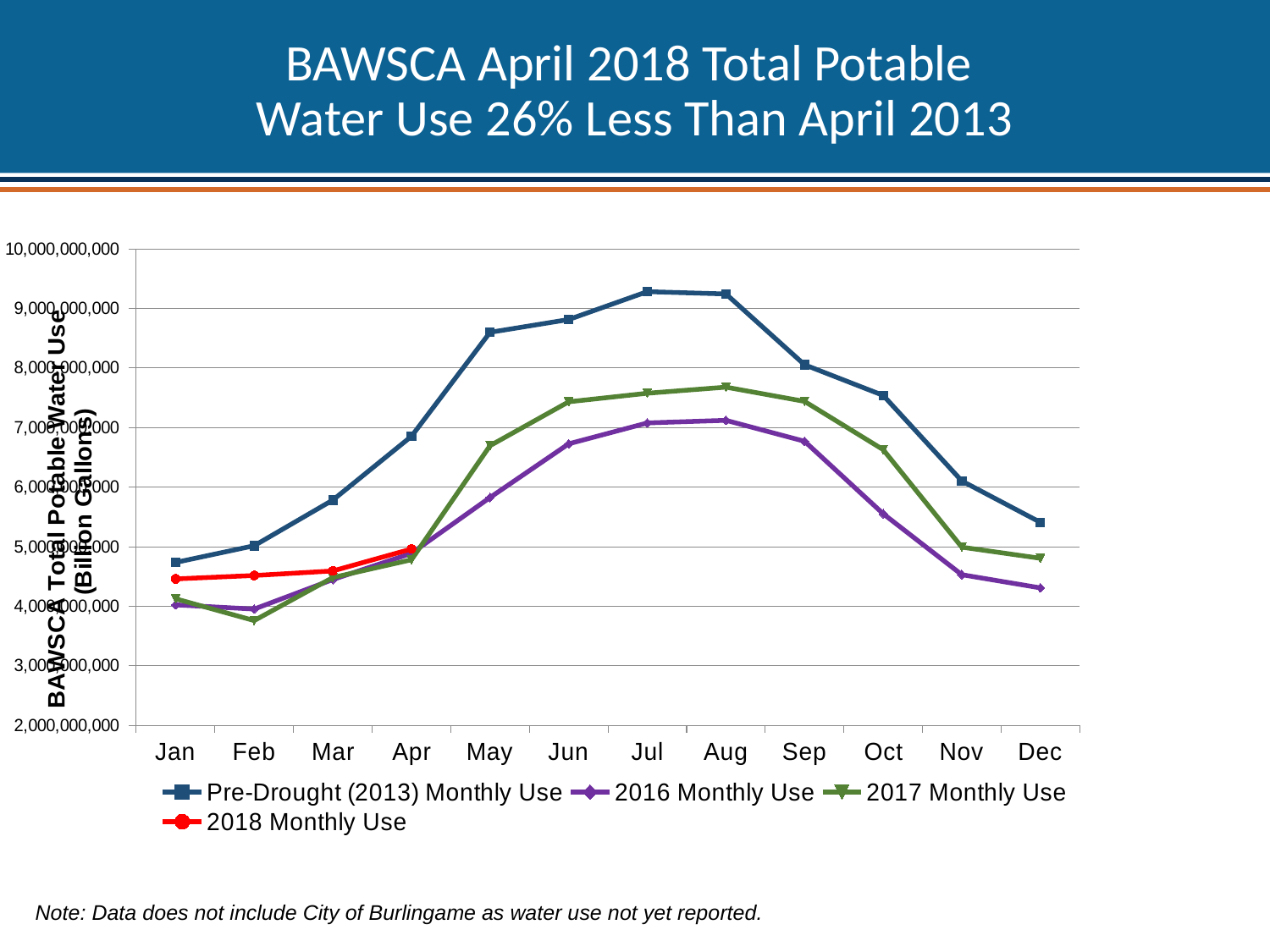
In which month is the 2017 Monthly Use lowest? Feb How many months are shown along the x axis? 12 Is the Pre-Drought (2013) Monthly Use value for Jul greater or less than 9,000,000,000? greater What kind of chart is shown on the slide? line chart How many series does the legend list? 4 Which is larger in Jun: the Pre-Drought (2013) Monthly Use or the 2017 Monthly Use? Pre-Drought (2013) Monthly Use How many data points are plotted for the 2018 Monthly Use series? 4 In which month is the Pre-Drought (2013) Monthly Use lowest? Jan Is the 2017 Monthly Use value for Feb greater or less than 4,000,000,000? less Does the 2018 Monthly Use series rise or fall from Jan to Apr? rise Is the 2016 Monthly Use value for Dec greater or less than 5,000,000,000? less What colour is the line for the 2018 Monthly Use series? red